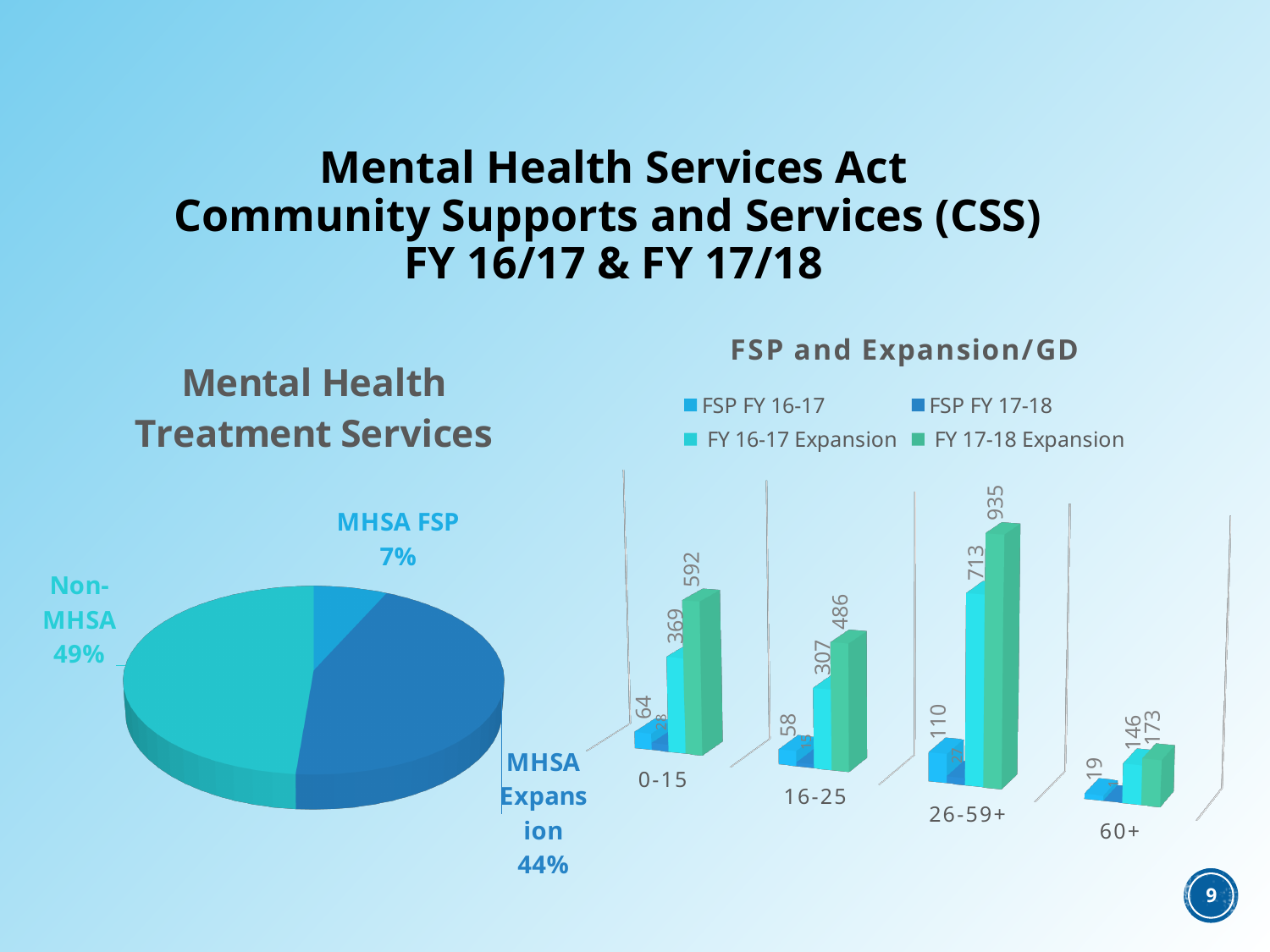
In the Mental Health Treatment Services pie chart, what share is MHSA FSP? 7% In the Mental Health Treatment Services pie chart, what share is Non-MHSA? 49% How many age groups are shown on the x axis of the FSP and Expansion/GD chart? 4 In the FSP and Expansion/GD chart, what is the FSP FY 16-17 value for the 60+ age group? 19 What kind of chart is the Mental Health Treatment Services chart? Pie chart In the FSP and Expansion/GD chart, what is the difference between the FY 17-18 Expansion and FY 16-17 Expansion values for the 16-25 age group? 179 In the Mental Health Treatment Services pie chart, which slice is the largest? Non-MHSA In the FSP and Expansion/GD chart, which age group has the highest FY 17-18 Expansion value? 26-59+ In the Mental Health Treatment Services pie chart, which slice is the smallest? MHSA FSP In the FSP and Expansion/GD chart, what is the FY 17-18 Expansion value for the 26-59+ age group? 935 In the FSP and Expansion/GD chart, what is the FY 16-17 Expansion value for the 0-15 age group? 369 How many series does the legend of the FSP and Expansion/GD chart list? 4